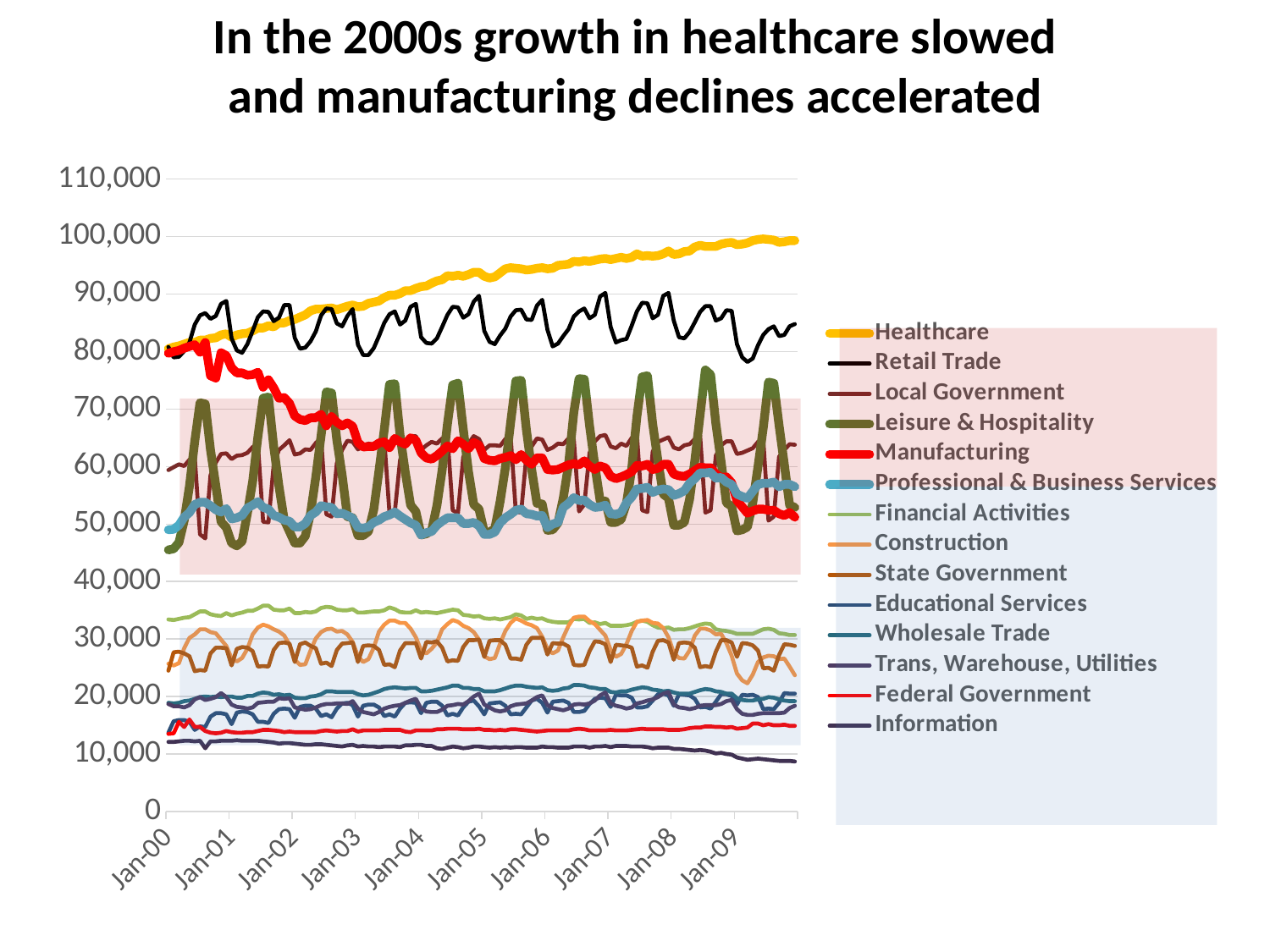
Is the Manufacturing value at the right end of the chart greater or less than 60,000? less Which series has the highest value at the right end of the chart? Healthcare How many series does the legend list? 14 Does the Healthcare line rise or fall from Jan-00 to the end of the chart? rise What is the title of the chart? In the 2000s growth in healthcare slowed and manufacturing declines accelerated Does the Manufacturing line rise or fall from Jan-00 to the end of the chart? fall What kind of chart is shown on the slide? line chart At Jan-00, which is larger: Manufacturing or Leisure & Hospitality? Manufacturing Is the Information value at the right end of the chart greater or less than 10,000? less Which series has the lowest value at the right end of the chart? Information Is the Healthcare value at the right end of the chart greater or less than 90,000? greater At the right end of the chart, which is larger: Healthcare or Retail Trade? Healthcare